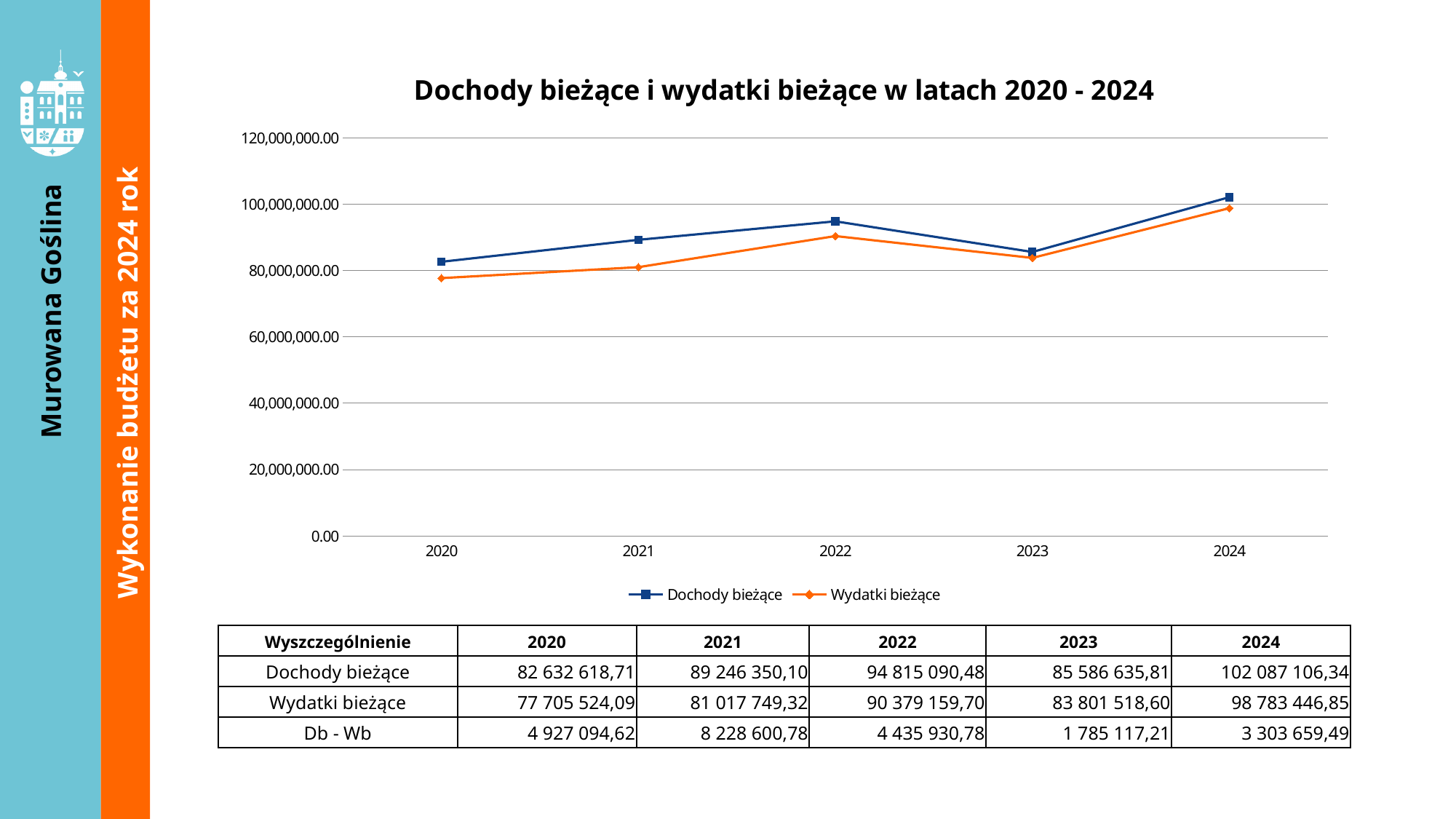
What is the difference between Dochody bieżące and Wydatki bieżące in 2021? 8 228 600,78 Is the value of Wydatki bieżące for 2022 greater or less than 80,000,000.00? greater What is the value of Wydatki bieżące for 2020? 77 705 524,09 How many series does the chart legend list? 2 What is the title of the chart? Dochody bieżące i wydatki bieżące w latach 2020 - 2024 How many years are plotted along the x axis of the chart? 5 What type of chart is shown on the slide? line chart Which is larger in 2023: Dochody bieżące or Wydatki bieżące? Dochody bieżące What is the value of Dochody bieżące for 2024? 102 087 106,34 In which year is Dochody bieżące the highest? 2024 In which year is Wydatki bieżące the lowest? 2020 What is the value of Dochody bieżące for 2022? 94 815 090,48